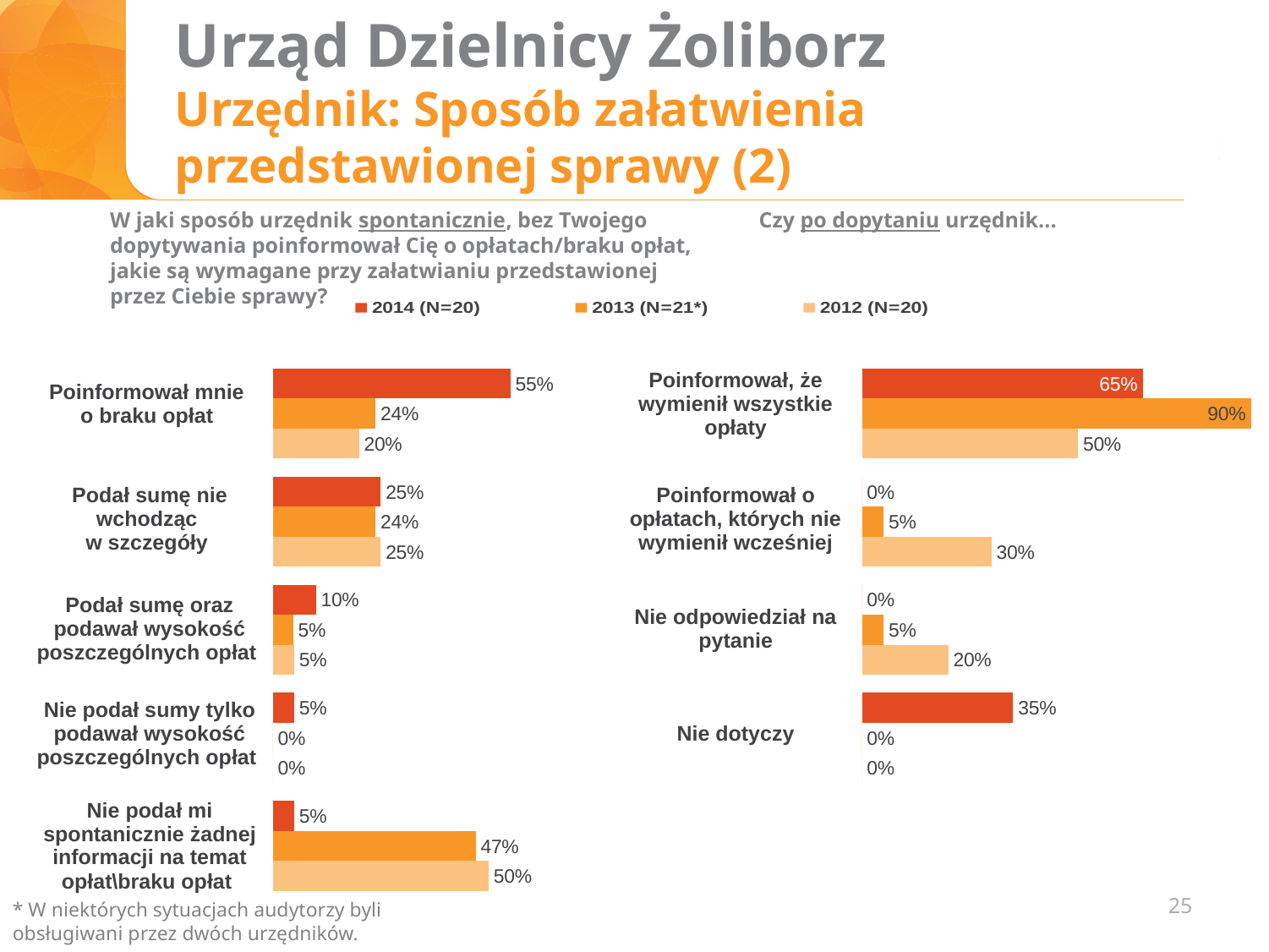
In the right chart, which category has the lowest 2012 value? Nie dotyczy What type of chart is the right chart? Bar chart In the left chart, which category has the highest 2014 value? Poinformował mnie o braku opłat In the left chart, what is the 2014 value for "Poinformował mnie o braku opłat"? 55% In the left chart, which is larger for "Nie podał mi spontanicznie żadnej informacji na temat opłat\braku opłat": the 2013 value or the 2014 value? 2013 In the right chart, what is the 2013 value for "Poinformował, że wymienił wszystkie opłaty"? 90% In the right chart, what is the 2014 value for "Nie dotyczy"? 35% In the left chart, what is the 2012 value for "Nie podał mi spontanicznie żadnej informacji na temat opłat\braku opłat"? 50% In the left chart, what is the difference between the 2014 and 2013 values for "Poinformował mnie o braku opłat"? 31% How many categories does the left chart show? 5 How many series does the legend list? 3 In the right chart, what is the difference between the 2013 and 2012 values for "Poinformował, że wymienił wszystkie opłaty"? 40%